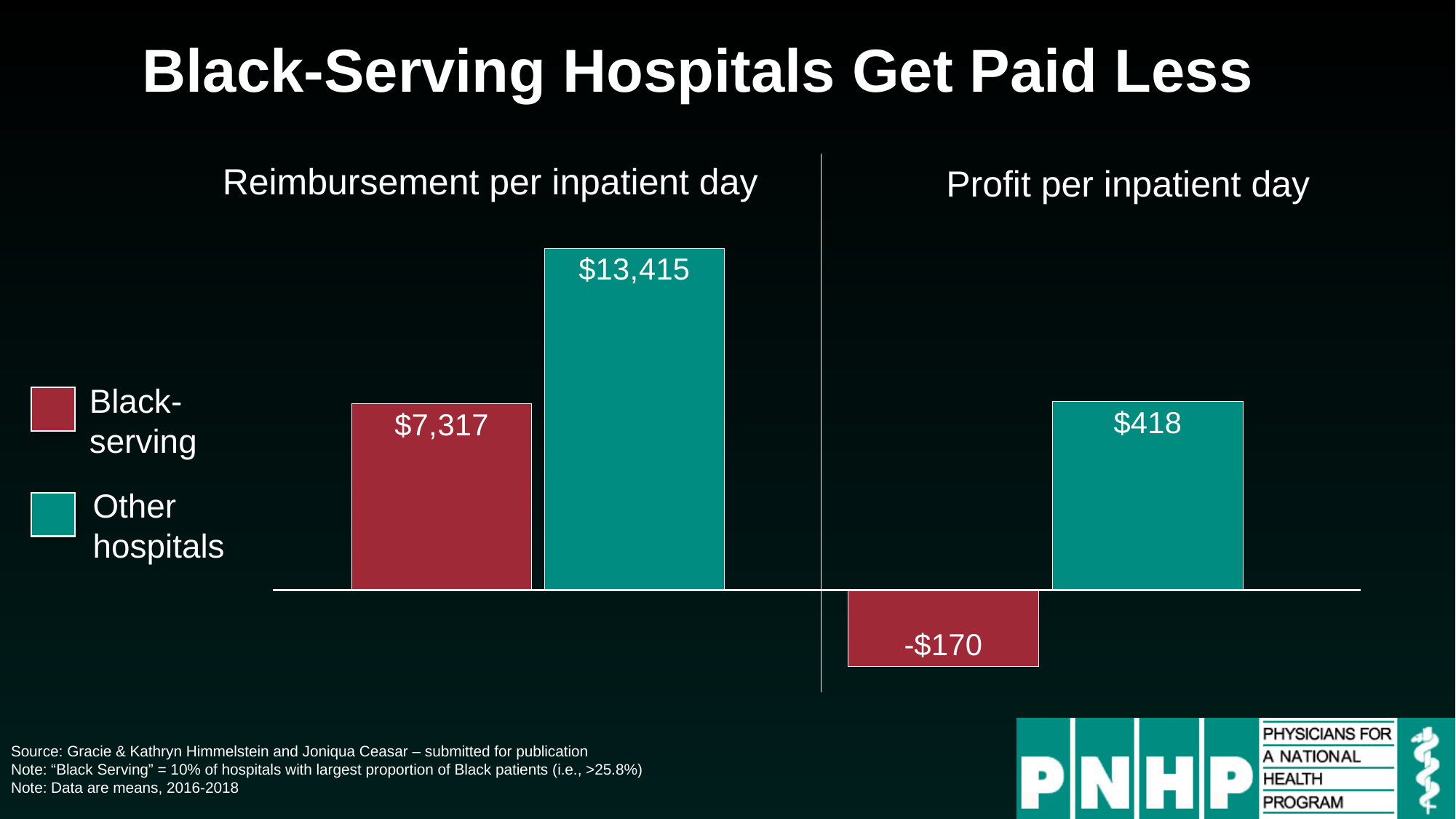
What is the difference in profit per inpatient day between other hospitals and Black-serving hospitals? $588 What is the profit per inpatient day for other hospitals? $418 Which group has the higher reimbursement per inpatient day? Other hospitals What is the difference in reimbursement per inpatient day between other hospitals and Black-serving hospitals? $6,098 What is the reimbursement per inpatient day for Black-serving hospitals? $7,317 What is the title of the slide? Black-Serving Hospitals Get Paid Less How many groups does the legend list? 2 What is the profit per inpatient day for Black-serving hospitals? -$170 What colour represents Black-serving hospitals in the chart? Red What is the reimbursement per inpatient day for other hospitals? $13,415 What kind of chart is shown on the slide? Bar chart Which group has the lower profit per inpatient day? Black-serving